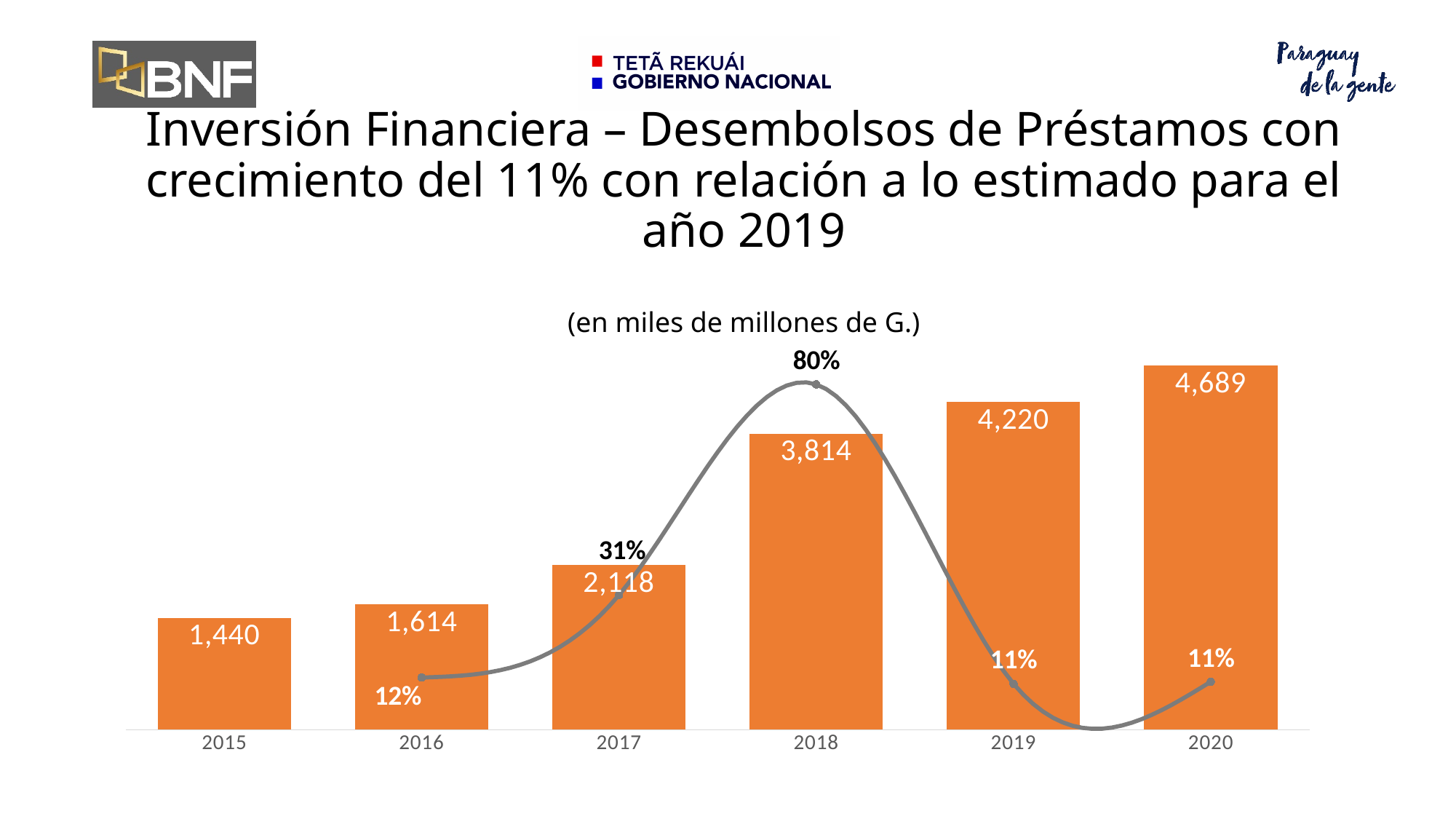
What is the value of the bar for 2018? 3,814 Which is larger, the bar value for 2018 or for 2019? 2019 Which year has the highest bar value? 2020 What growth percentage is shown on the line for 2017? 31% What unit is stated in the chart subtitle? en miles de millones de G. What is the value of the bar for 2015? 1,440 What is the difference between the bar values for 2020 and 2019? 469 In which year does the growth line reach its highest percentage? 2018 What is the difference between the bar values for 2017 and 2016? 504 Which year has the lowest bar value? 2015 Do the bar values rise or fall from 2015 to 2020? rise How many years are shown on the x axis? 6